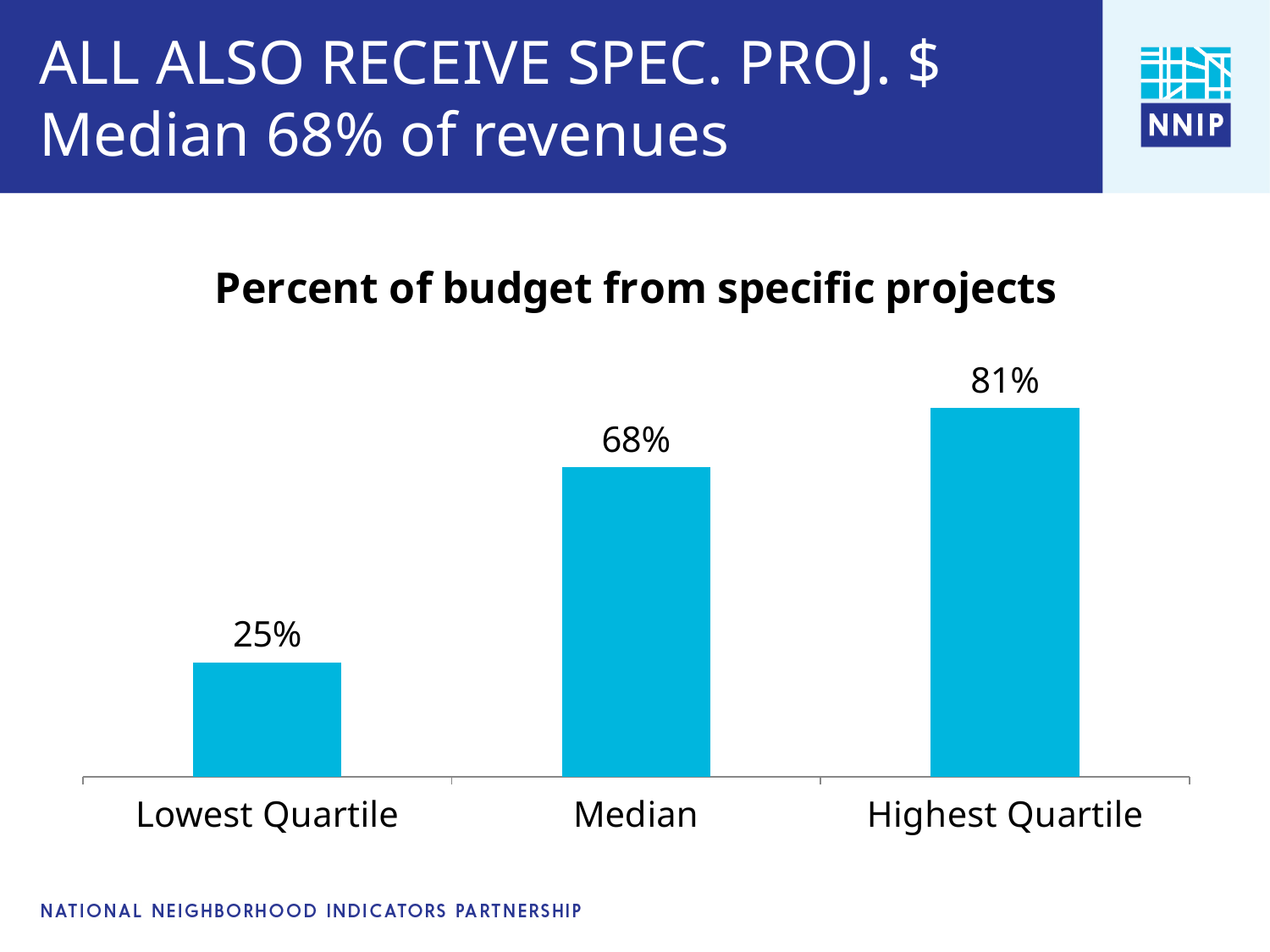
Which is larger, the value for Median or the value for Highest Quartile? Highest Quartile Do the values rise or fall from left to right across the categories? Rise What is the value for Highest Quartile? 81% How many categories are shown in the chart? 3 Which category has the highest value? Highest Quartile What is the difference between the Median and Lowest Quartile values? 43% What is the difference between the Highest Quartile and Lowest Quartile values? 56% What is the value for Lowest Quartile? 25% What kind of chart is shown on the slide? Bar chart Which category has the lowest value? Lowest Quartile What is the value for Median? 68% What is the title of the chart? Percent of budget from specific projects